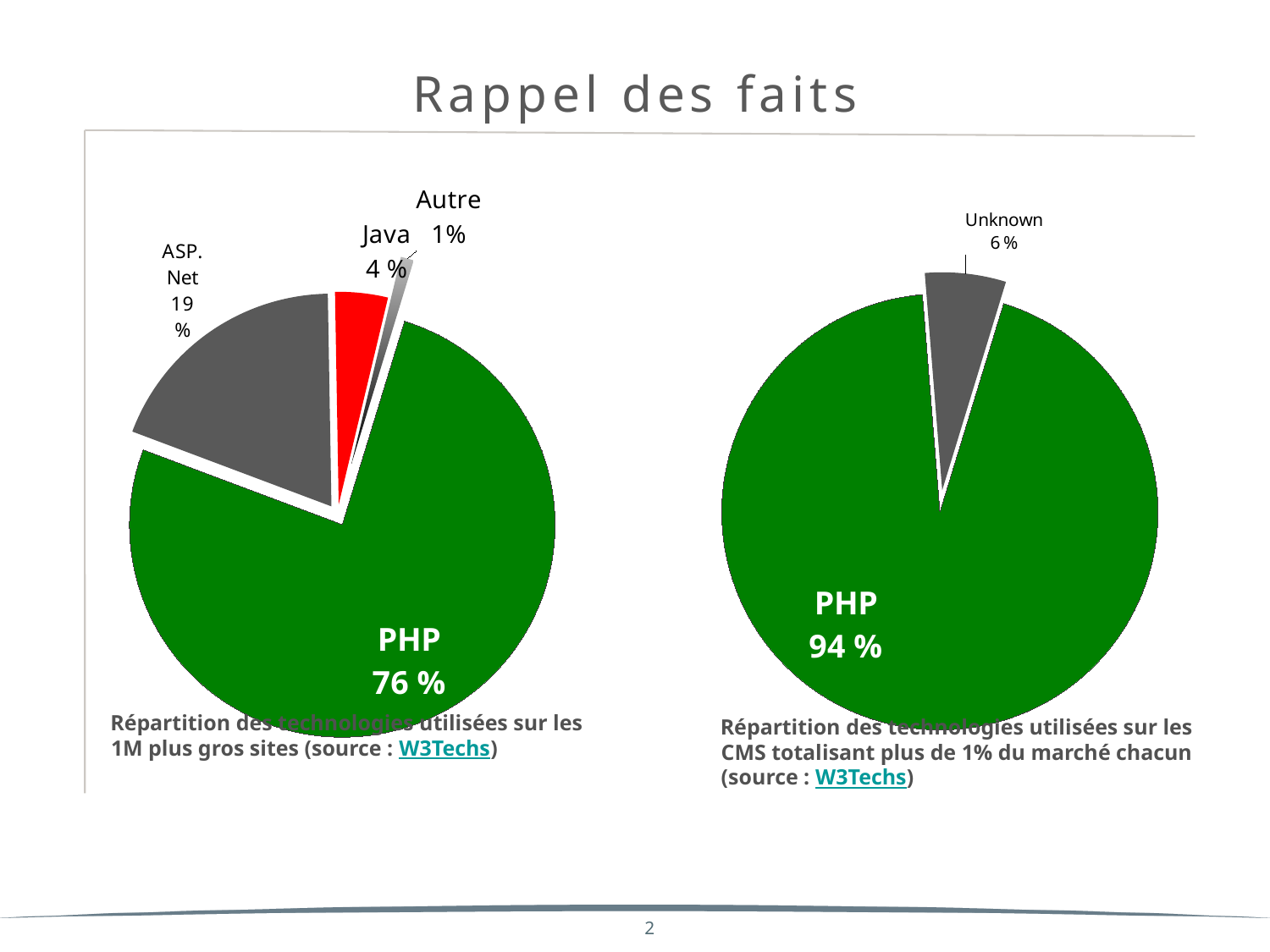
In the left pie chart, what share does Java have? 4 % In the right pie chart, what share does Unknown have? 6 % In the left pie chart, which is larger, the Java slice or the ASP.Net slice? ASP.Net In the right pie chart, what share does PHP have? 94 % How many slices does the left pie chart have? 4 In the left pie chart, what share does ASP.Net have? 19 % In the left pie chart, what share does PHP have? 76 % In the left pie chart, what share does Autre have? 1% In the left pie chart, what is the difference between the PHP share and the ASP.Net share? 57 % What kind of chart is the right chart? Pie chart In the left pie chart, which category has the smallest slice? Autre In the left pie chart, which category has the largest slice? PHP